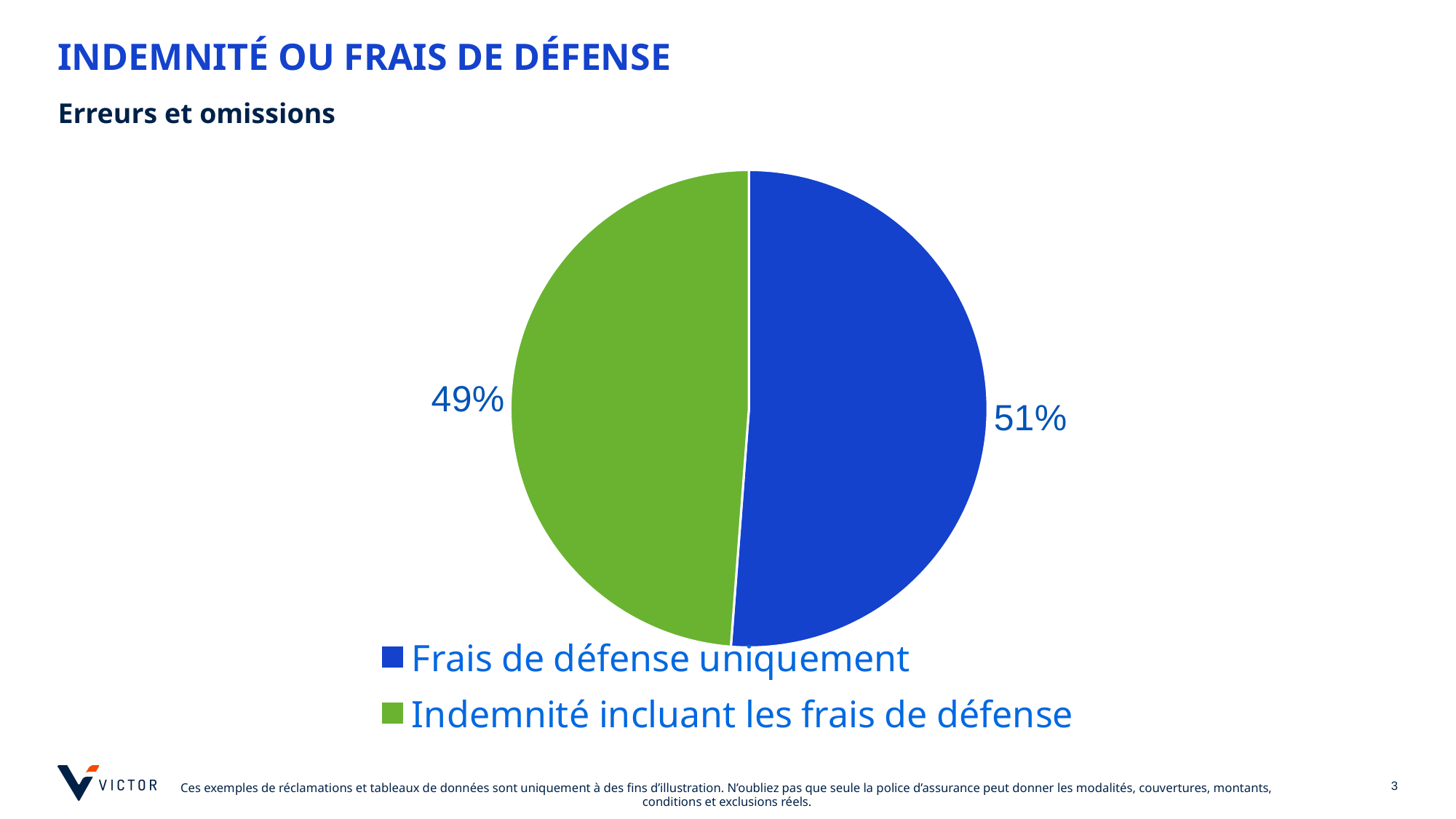
How many slices does the pie chart have? 2 What share of the pie is 'Frais de défense uniquement'? 51% Which slice is the largest? Frais de défense uniquement What kind of chart is shown on the slide? pie chart What share of the pie is 'Indemnité incluant les frais de défense'? 49% Which colour represents 'Indemnité incluant les frais de défense'? green How many entries does the legend list? 2 Is the share for 'Indemnité incluant les frais de défense' greater or less than 50%? less What is the difference in percentage points between 'Frais de défense uniquement' and 'Indemnité incluant les frais de défense'? 2% Which slice is the smallest? Indemnité incluant les frais de défense Is the share for 'Frais de défense uniquement' greater or less than 50%? greater Which colour represents 'Frais de défense uniquement'? blue